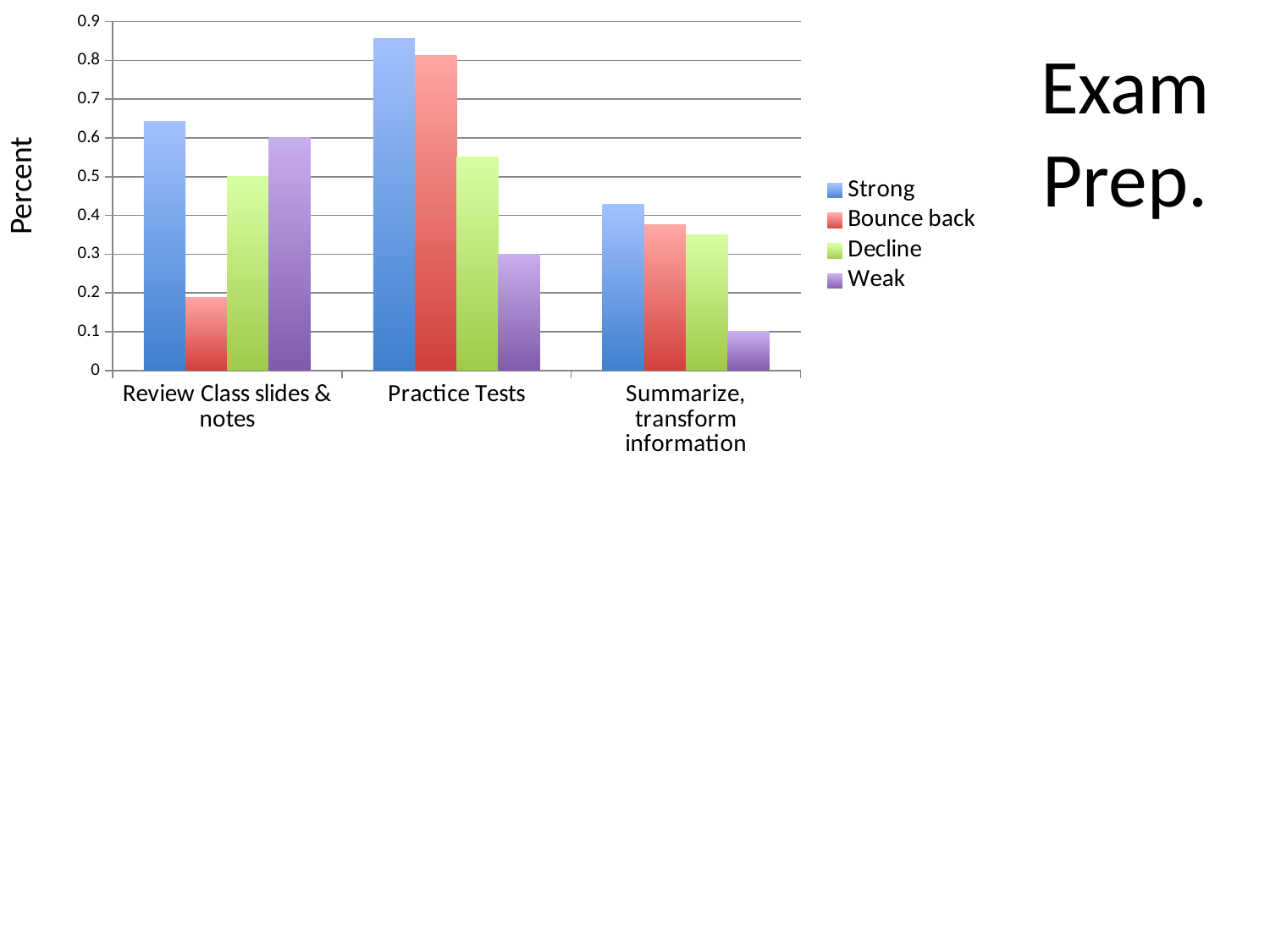
How many series does the legend list? 4 How many categories are shown on the x axis? 3 In Review Class slides & notes, which is larger: Strong or Bounce back? Strong Which series has the lowest bar in the Summarize, transform information category? Weak In which category is the Strong bar the highest? Practice Tests Is the value for Strong in Practice Tests greater or less than 0.8? greater In which category is the Weak bar the lowest? Summarize, transform information What kind of chart is shown on the slide? bar chart What colour represents the Decline series in the legend? green In Practice Tests, which is larger: Decline or Weak? Decline What is the label on the vertical axis? Percent